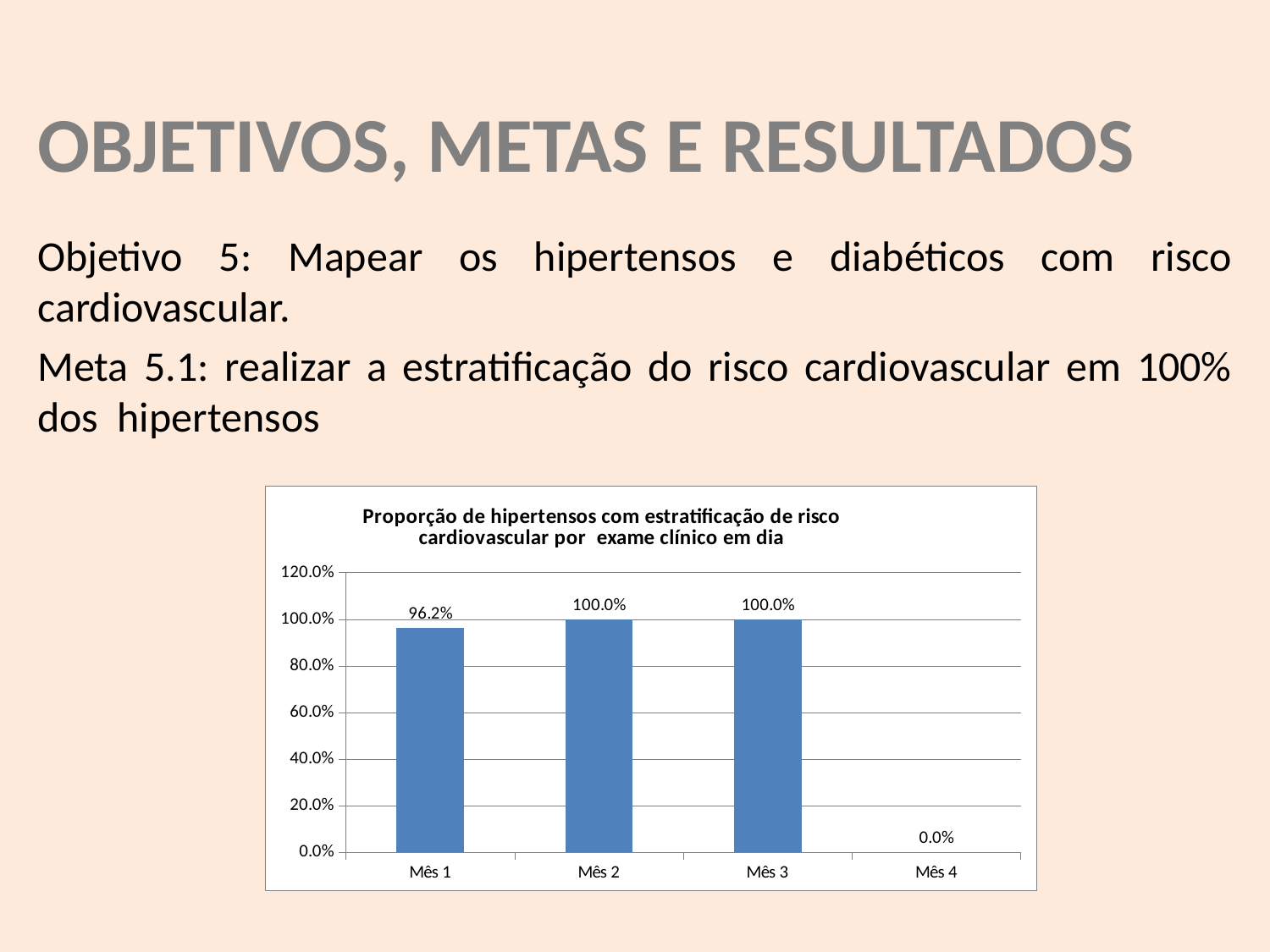
Do the values for Mês 2 and Mês 3 differ? No What is the value for Mês 2? 100.0% Which is larger, the value for Mês 1 or the value for Mês 3? Mês 3 How many categories are shown on the x axis? 4 What is the title of the chart? Proporção de hipertensos com estratificação de risco cardiovascular por exame clínico em dia Is the value for Mês 1 greater or less than 80.0%? greater Which category has the lowest value? Mês 4 What is the value for Mês 4? 0.0% What kind of chart is shown on the slide? bar chart What is the difference between the values for Mês 2 and Mês 1? 3.8% What is the value for Mês 1? 96.2% What is the highest value shown on the y axis? 120.0%